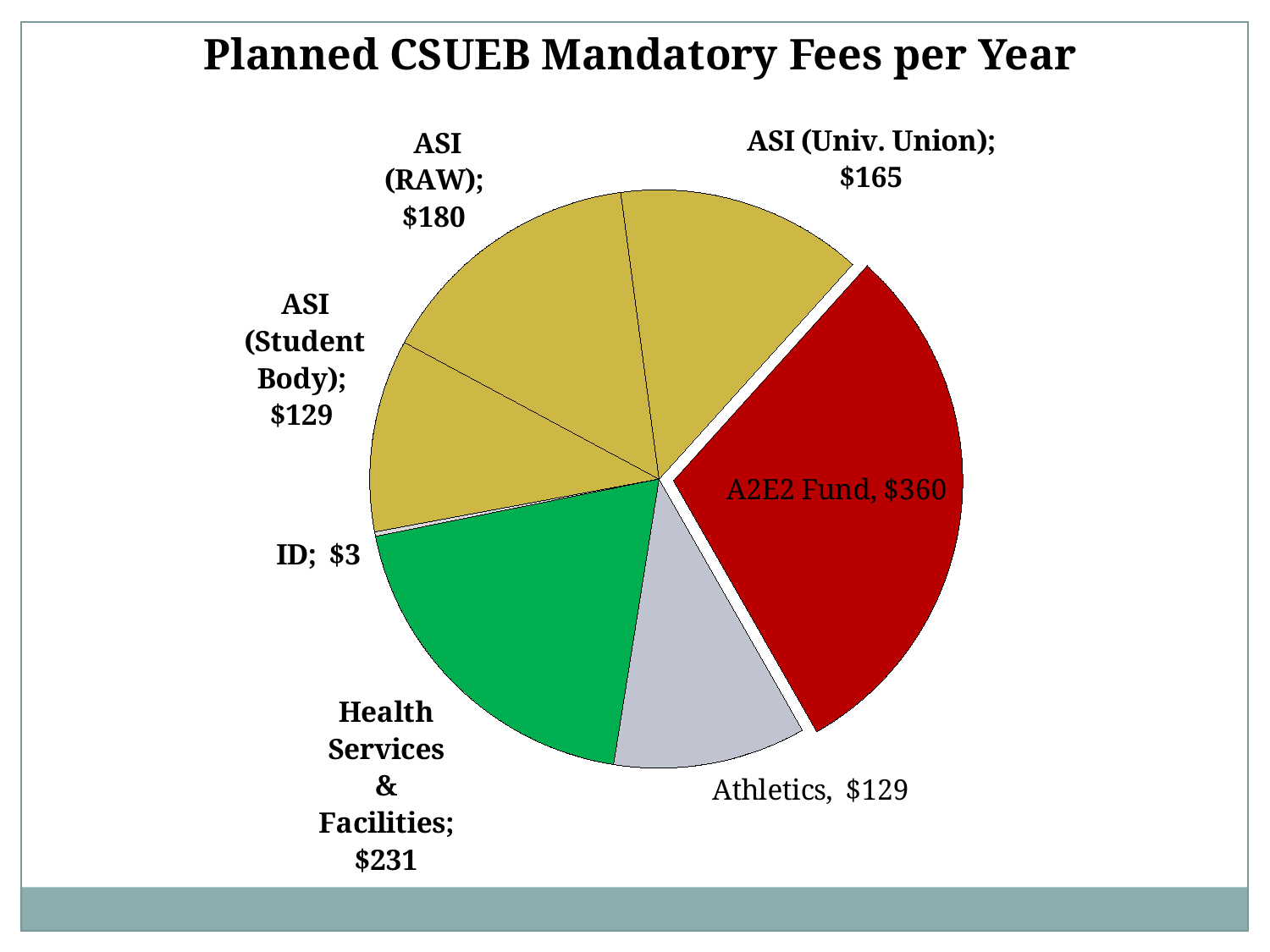
Which fee category has the smallest slice? ID What is the title of the chart? Planned CSUEB Mandatory Fees per Year What is the value of the A2E2 Fund slice? $360 What is the value for Athletics? $129 What is the value for Health Services & Facilities? $231 How many slices does the pie chart have? 7 Which fee category has the largest slice? A2E2 Fund What is the value for ASI (Univ. Union)? $165 What is the value for ASI (RAW)? $180 What kind of chart is shown on the slide? Pie chart Which is larger, Health Services & Facilities or ASI (RAW)? Health Services & Facilities What is the difference between the A2E2 Fund and Health Services & Facilities values? $129